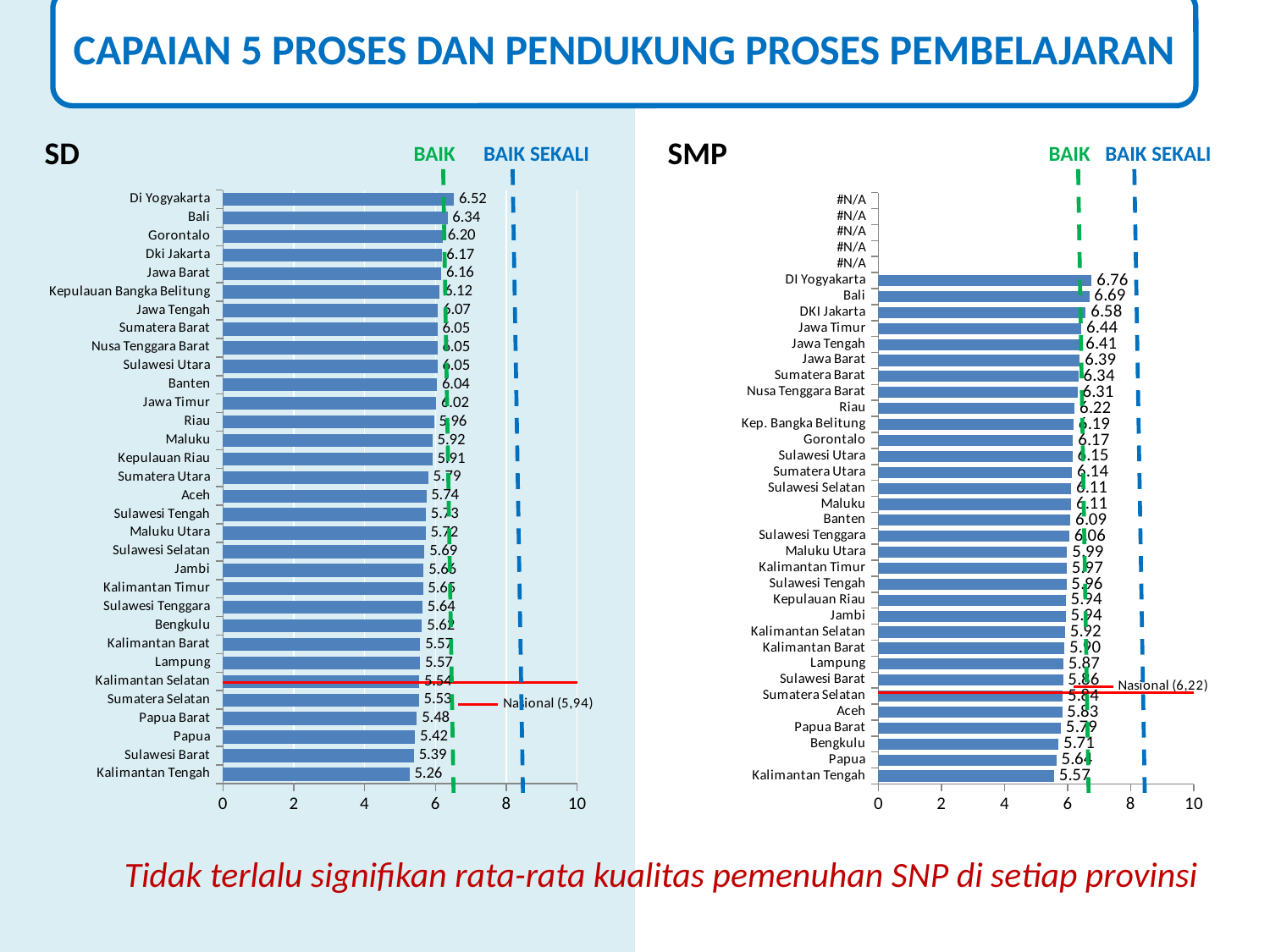
In the SMP chart, what national value (Nasional) is marked by the red line? 6,22 In the SMP chart, which province has the highest value? DI Yogyakarta In the SD chart, which province has the lowest value? Kalimantan Tengah What type of chart is the SD chart? Bar chart In the SD chart, what is the difference between Bali (6.34) and Kalimantan Tengah (5.26)? 1.08 In the SD chart, what is the value for Di Yogyakarta? 6.52 In the SD chart, what national value (Nasional) is marked by the red line? 5,94 In the SMP chart, what is the value for Kalimantan Tengah? 5.57 In the SMP chart, is the value for Papua greater or less than 6? less In the SD chart, what is the value for Papua? 5.42 In the SMP chart, what is the value for DI Yogyakarta? 6.76 In the SMP chart, which is larger, the value for Bali or the value for Jawa Timur? Bali